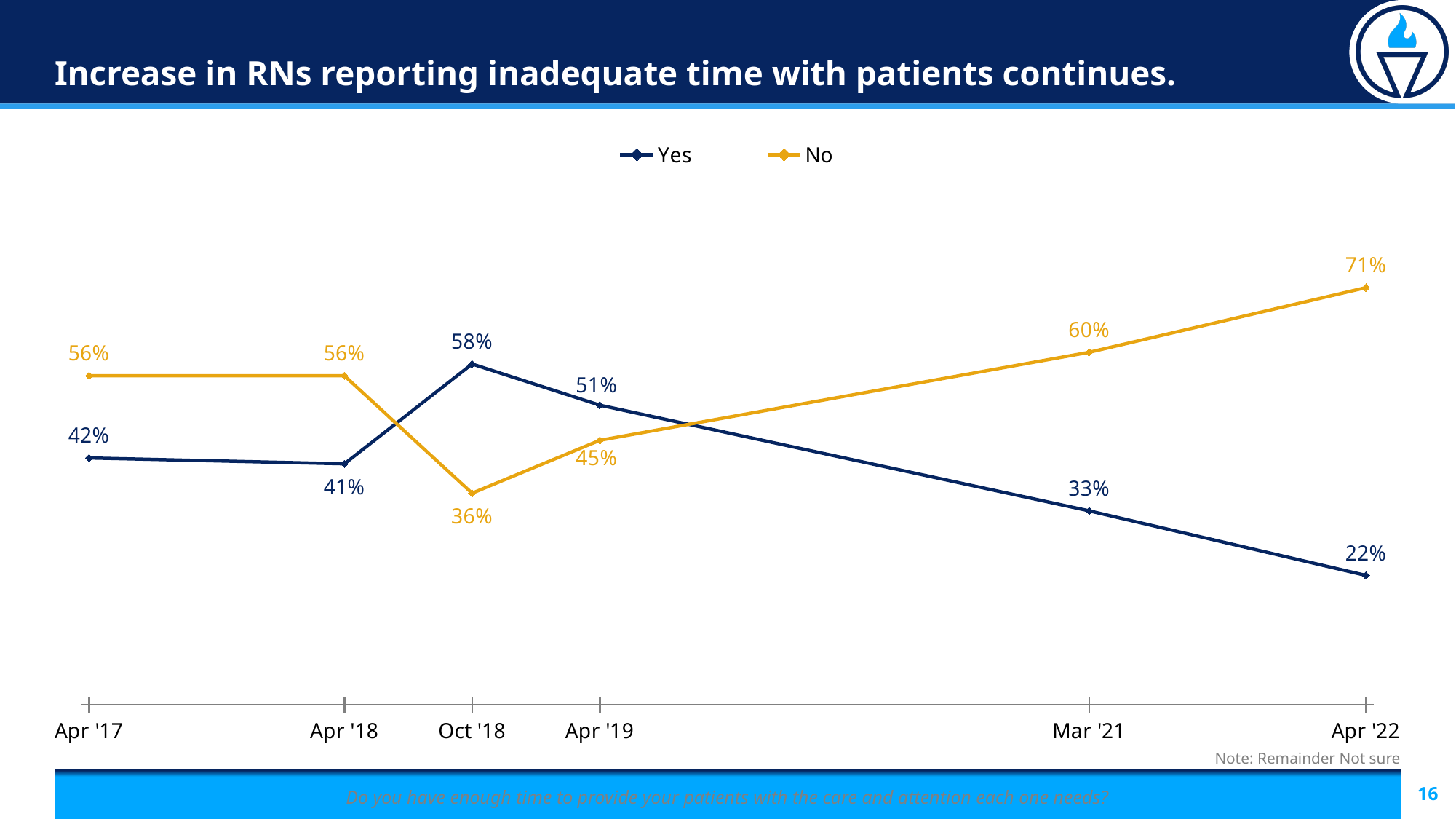
Does the Yes series rise or fall from Oct '18 to Apr '22? Fall What is the value for Yes in Apr '22? 22% What is the value for Yes in Oct '18? 58% What is the value for No in Oct '18? 36% What is the value for No in Mar '21? 60% In which period is the Yes series lowest? Apr '22 What is the difference between No and Yes in Apr '22? 49% In which period is the No series highest? Apr '22 What kind of chart is shown? Line chart How many time periods are shown on the x axis? 6 How many series does the legend list? 2 Which is larger in Apr '19, Yes or No? Yes